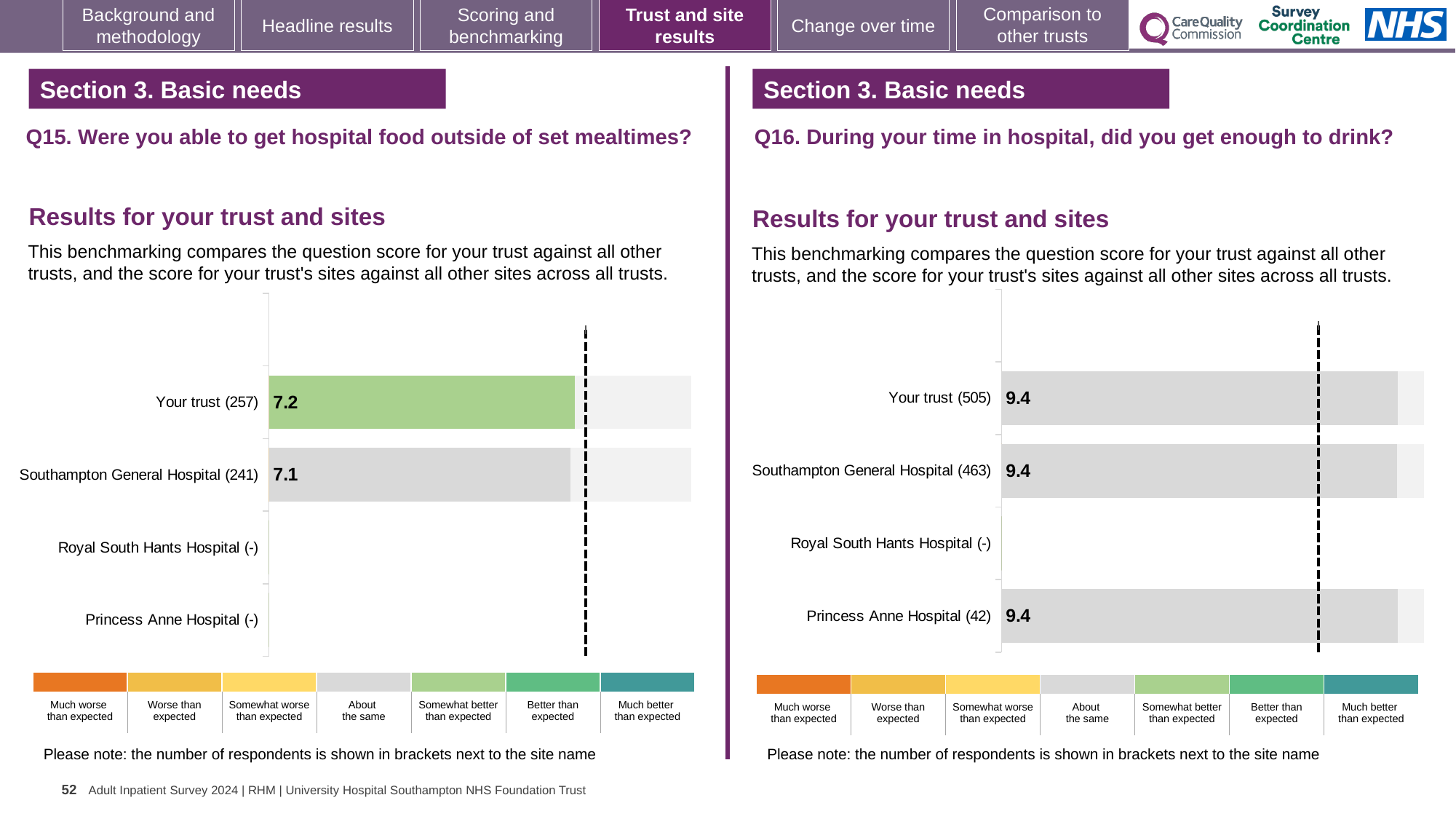
On the Q16 chart, how many respondents are shown in brackets for Southampton General Hospital? 463 On the Q16 chart, how many site/trust categories are listed on the vertical axis? 4 On the Q16 chart, what is the score for Princess Anne Hospital? 9.4 On the Q15 chart, how many respondents are shown in brackets for Your trust? 257 On the Q15 chart, what is the difference between the score for Your trust and the score for Southampton General Hospital? 0.1 On the Q15 chart, what is the score for Southampton General Hospital? 7.1 On the Q15 chart, what is the score for Your trust? 7.2 What type of chart is used on the Q15 side of the slide? Bar chart On the Q15 chart, which has the higher score, Your trust or Southampton General Hospital? Your trust On the Q15 chart, which benchmark category does the green colour of the Your trust bar correspond to in the legend? Somewhat better than expected On the Q16 chart, what is the score for Your trust? 9.4 On the Q16 chart, which site has no score shown (marked with a dash)? Royal South Hants Hospital